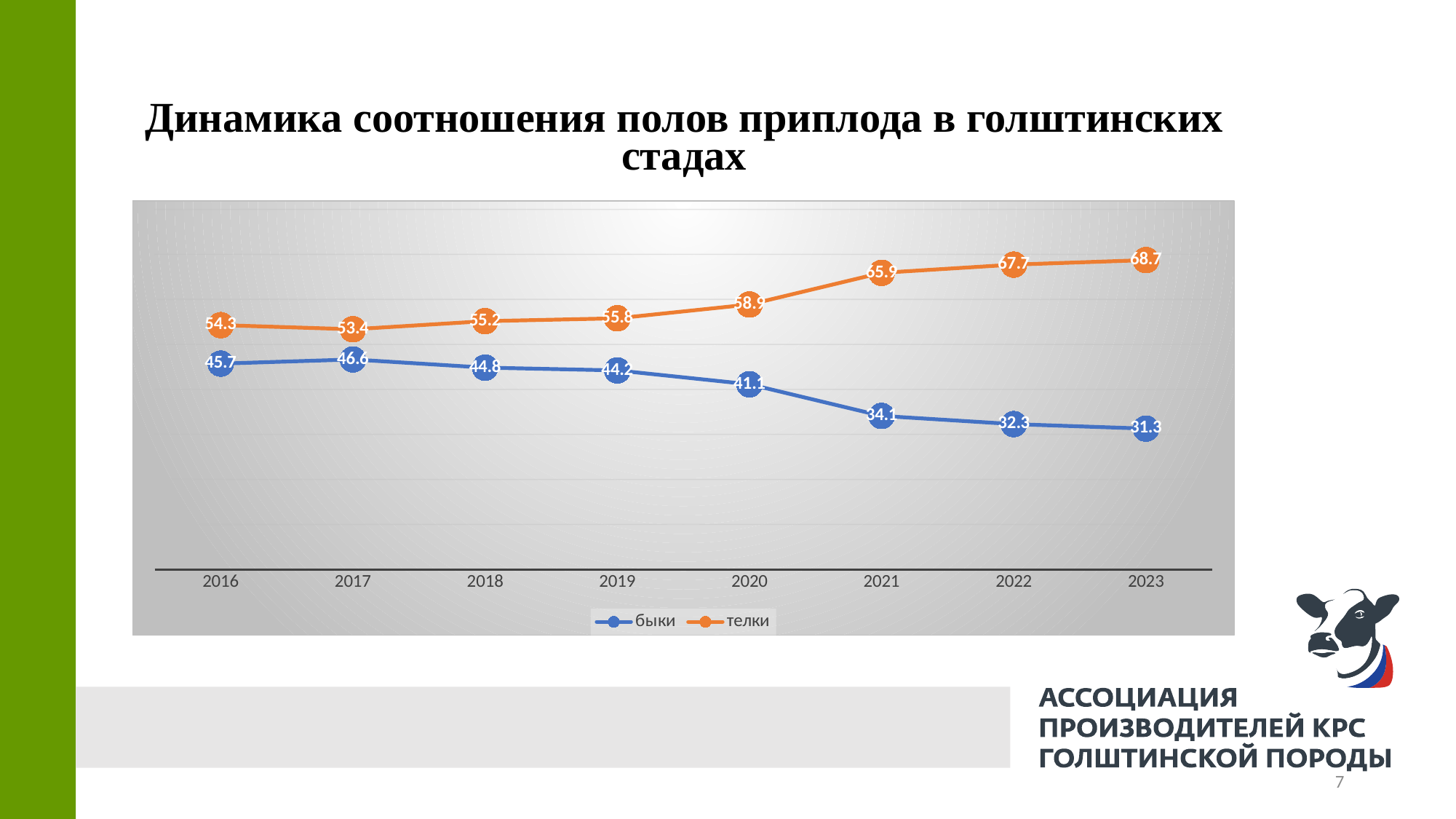
Does the value for быки rise or fall from 2017 to 2023? Fall What is the value for быки in 2020? 41.1 In which year is the value for быки highest? 2017 What is the value for телки in 2016? 54.3 What is the value for телки in 2023? 68.7 What is the title of the chart on the slide? Динамика соотношения полов приплода в голштинских стадах What type of chart is shown on the slide? Line chart Which series has the larger value in 2021, быки or телки? телки How many series does the legend list? 2 How many years are shown on the x axis? 8 What is the difference between the телки and быки values in 2023? 37.4 In which year is the value for телки lowest? 2017